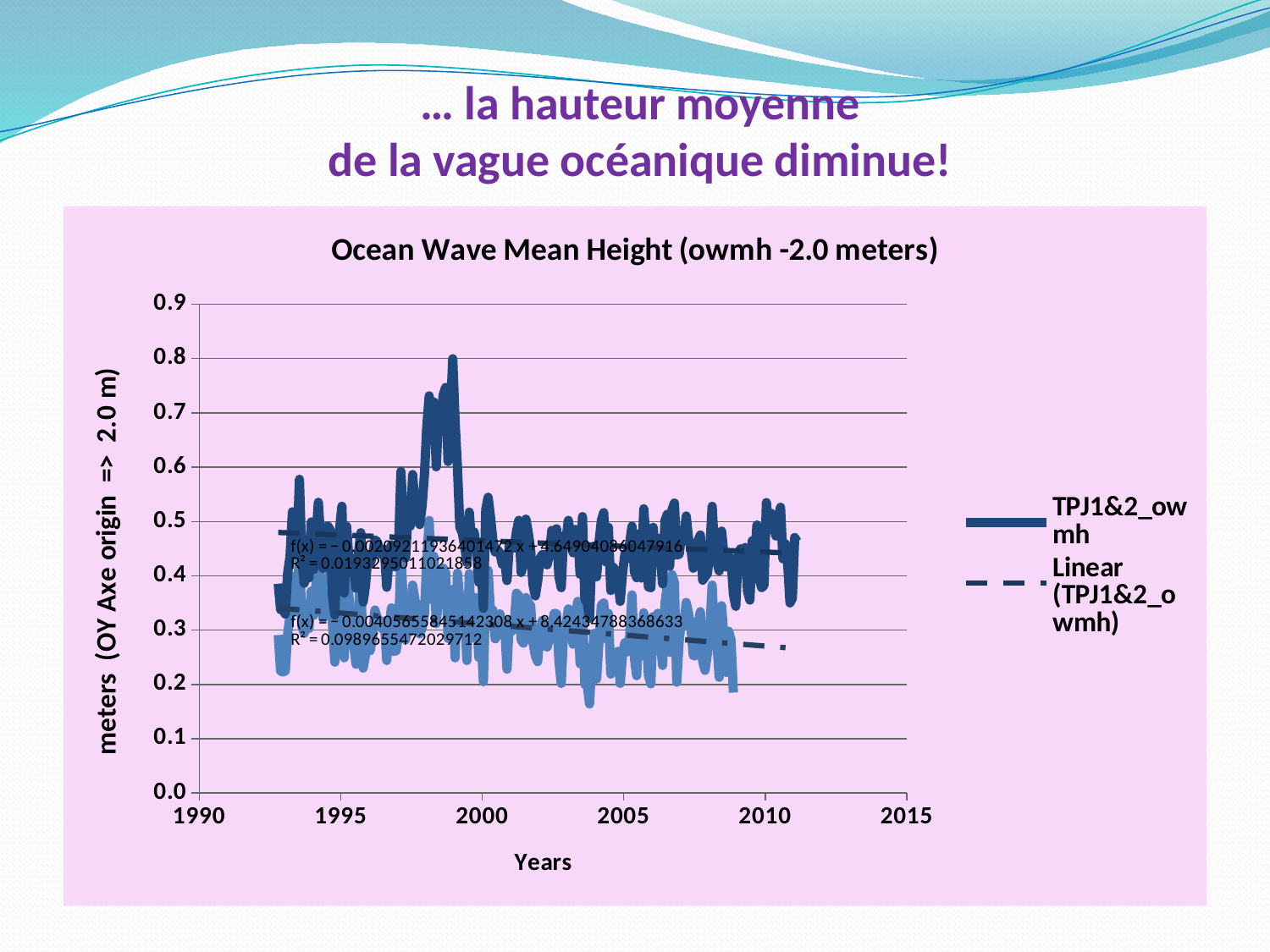
Which series generally has higher values, the dark blue series or the light blue series? the dark blue series Is the lowest value of the light blue series around 2004 greater or less than 0.2? less Is the peak value of the dark blue series around 1999 greater or less than 0.7? greater What kind of chart is shown on the slide? line chart What R² value is printed for the upper (dark blue) trend line? 0.0193295011021858 Do the dashed linear trend lines rise or fall from left to right across the years? fall What is the highest tick value shown on the y axis? 0.9 What is the label of the x axis? Years Is the value of the dark blue series at the start of the data (around 1993) greater or less than 0.6? less How many entries does the chart legend list? 2 What R² value is printed for the lower (light blue) trend line? 0.0989655472029712 What is the title of the chart? Ocean Wave Mean Height (owmh -2.0 meters)